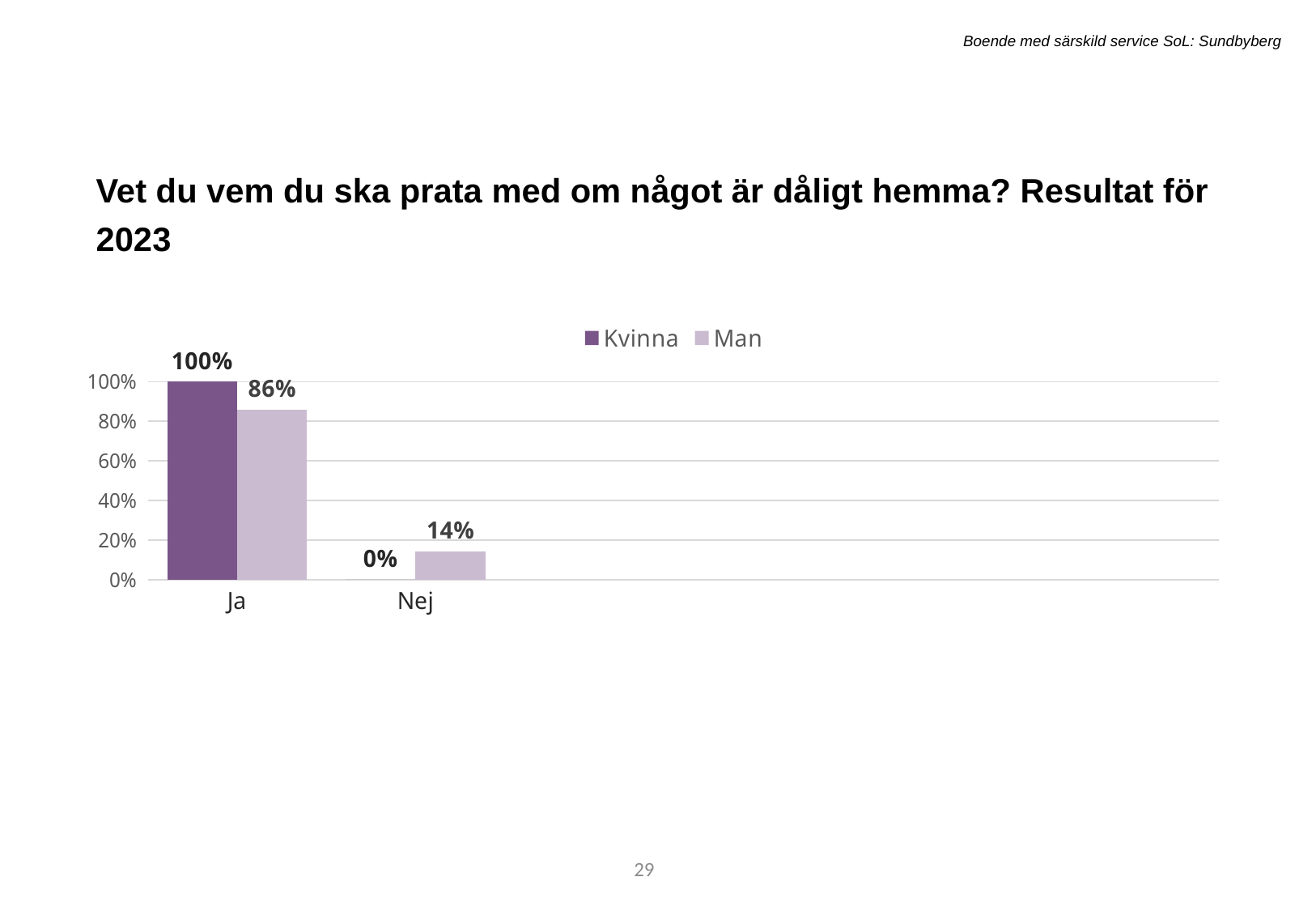
What is the value for Kvinna in the Nej category? 0% Which category has the lowest value for the Kvinna series? Nej What is the value for Kvinna in the Ja category? 100% What is the value for Man in the Nej category? 14% What is the value for Man in the Ja category? 86% How many categories are shown on the x axis? 2 Which is larger in the Nej category, Kvinna or Man? Man How many series does the legend list? 2 Which category has the highest value for the Man series? Ja What is the difference between the Kvinna and Man values in the Ja category? 14% Is the value for Man in the Ja category greater or less than 80%? greater What kind of chart is shown on the slide? Bar chart